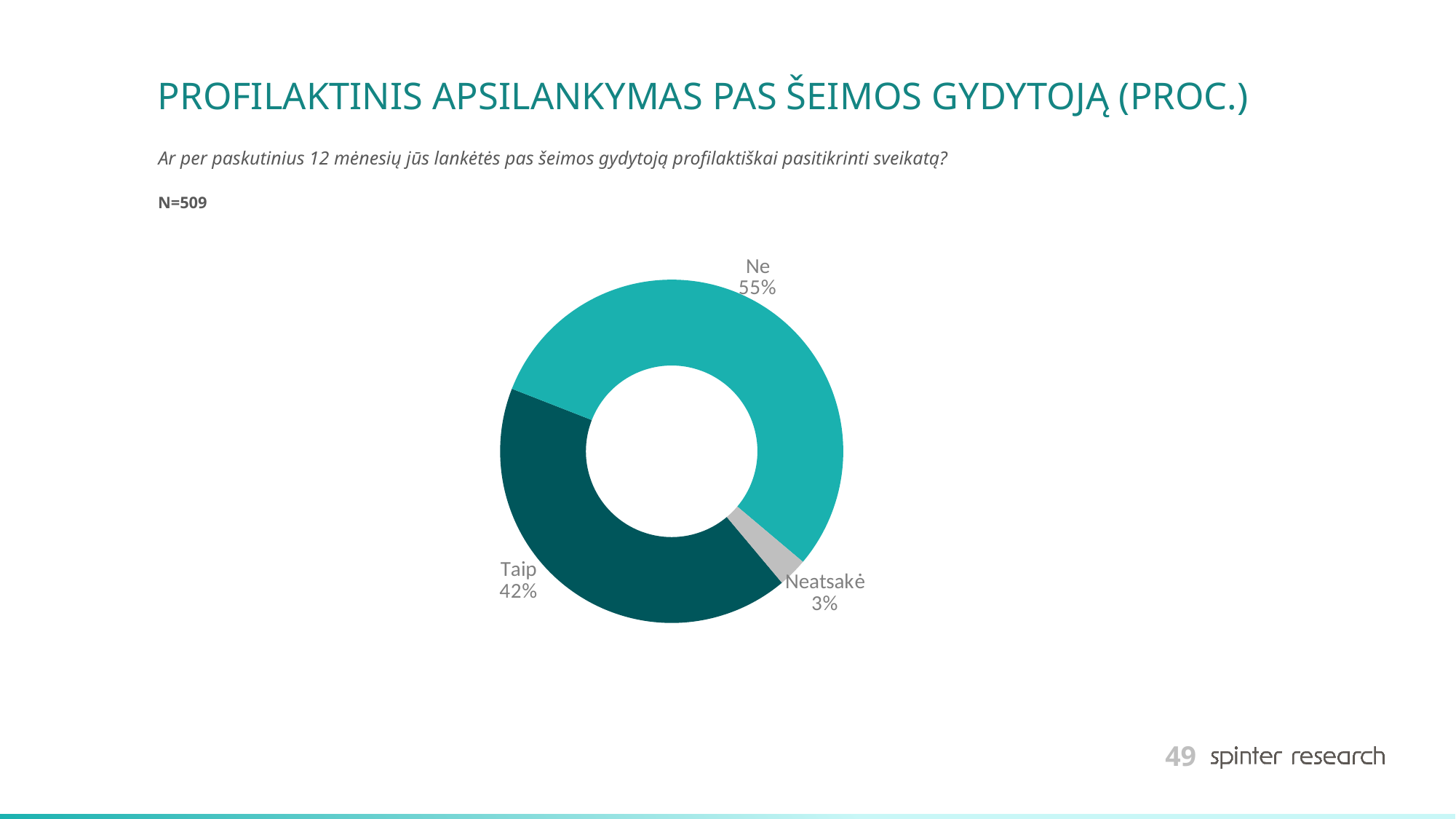
What is the combined share of "Taip" and "Ne"? 97% What is the sample size (N) stated on the slide? N=509 What kind of chart is shown on the slide? Pie chart (doughnut) What percentage of respondents answered "Taip"? 42% What percentage of respondents answered "Ne"? 55% Which category has the smallest share of the chart? Neatsakė What colour is the "Neatsakė" slice? Grey What is the difference in percentage points between "Ne" and "Taip"? 13 How many categories are shown in the chart? 3 Which is larger, the share for "Taip" or the share for "Neatsakė"? Taip Which category has the largest share of the chart? Ne What percentage of respondents are labelled "Neatsakė"? 3%